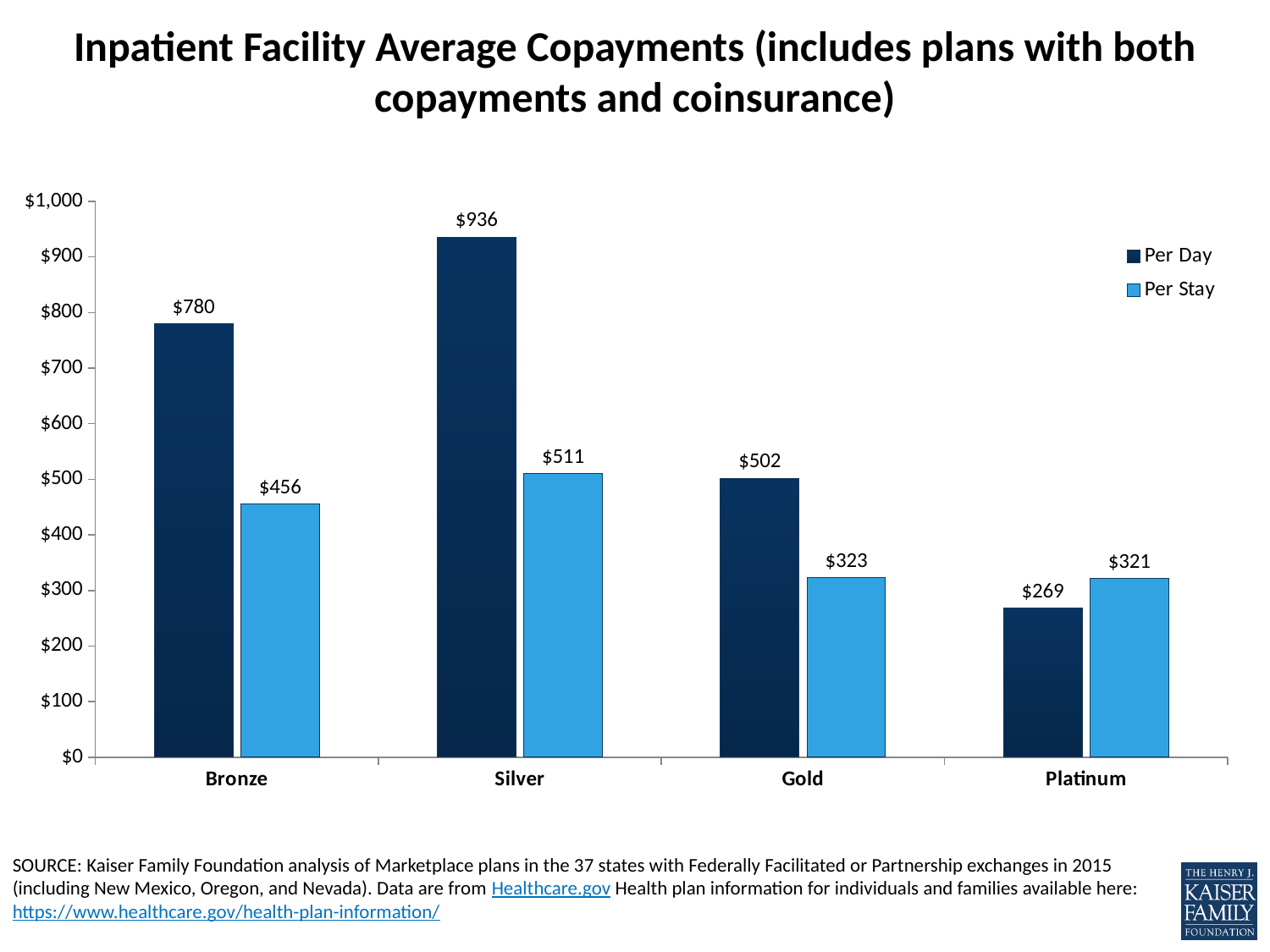
What is the Per Stay average copayment for Bronze plans? $456 Does the Per Day average copayment rise or fall from Silver to Platinum? Fall Which metal level has the highest Per Day average copayment? Silver What is the difference between the Per Day and Per Stay average copayments for Gold plans? $179 What kind of chart is shown on the slide? Bar chart Which metal level has the lowest Per Stay average copayment? Platinum What is the Per Day average copayment for Silver plans? $936 What is the Per Day average copayment for Platinum plans? $269 How many series does the legend list? 2 What are the two series listed in the legend? Per Day and Per Stay How many metal levels are shown on the x axis? 4 Which is larger for Platinum plans, the Per Day or the Per Stay average copayment? Per Stay